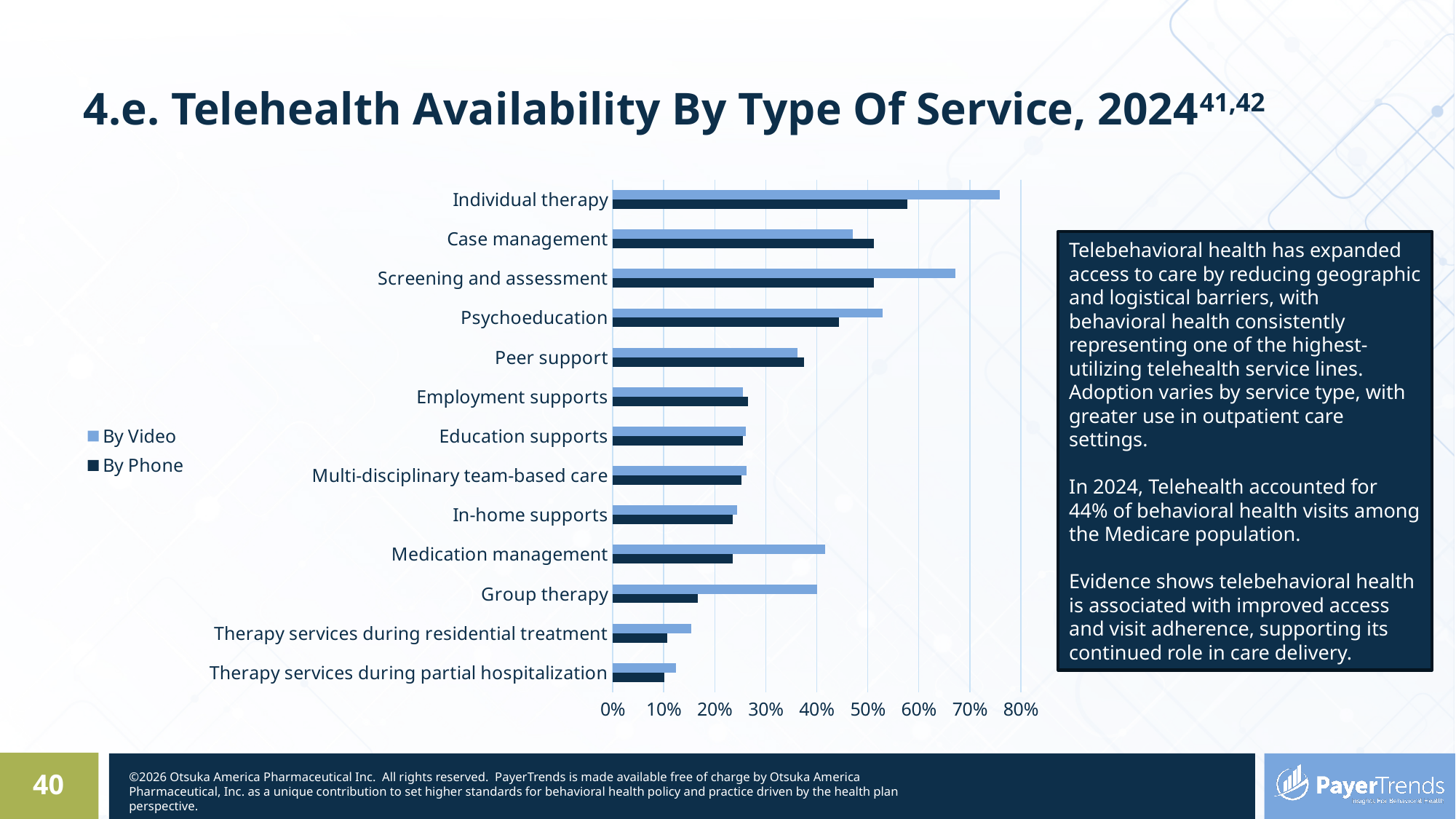
How many series does the legend list? 2 Is the By Video value for Individual therapy greater or less than 70%? greater What are the two legend entries on the chart? By Video and By Phone Is the By Video value for Screening and assessment greater or less than 60%? greater For Medication management, which is larger: the By Video value or the By Phone value? By Video Which type of service has the highest By Video value? Individual therapy For Case management, which is larger: the By Video value or the By Phone value? By Phone Which type of service has the highest By Phone value? Individual therapy Is the By Phone value for Group therapy greater or less than 20%? less Which type of service has the lowest By Video value? Therapy services during partial hospitalization What kind of chart is shown on the slide? Bar chart How many types of service are shown on the chart? 13